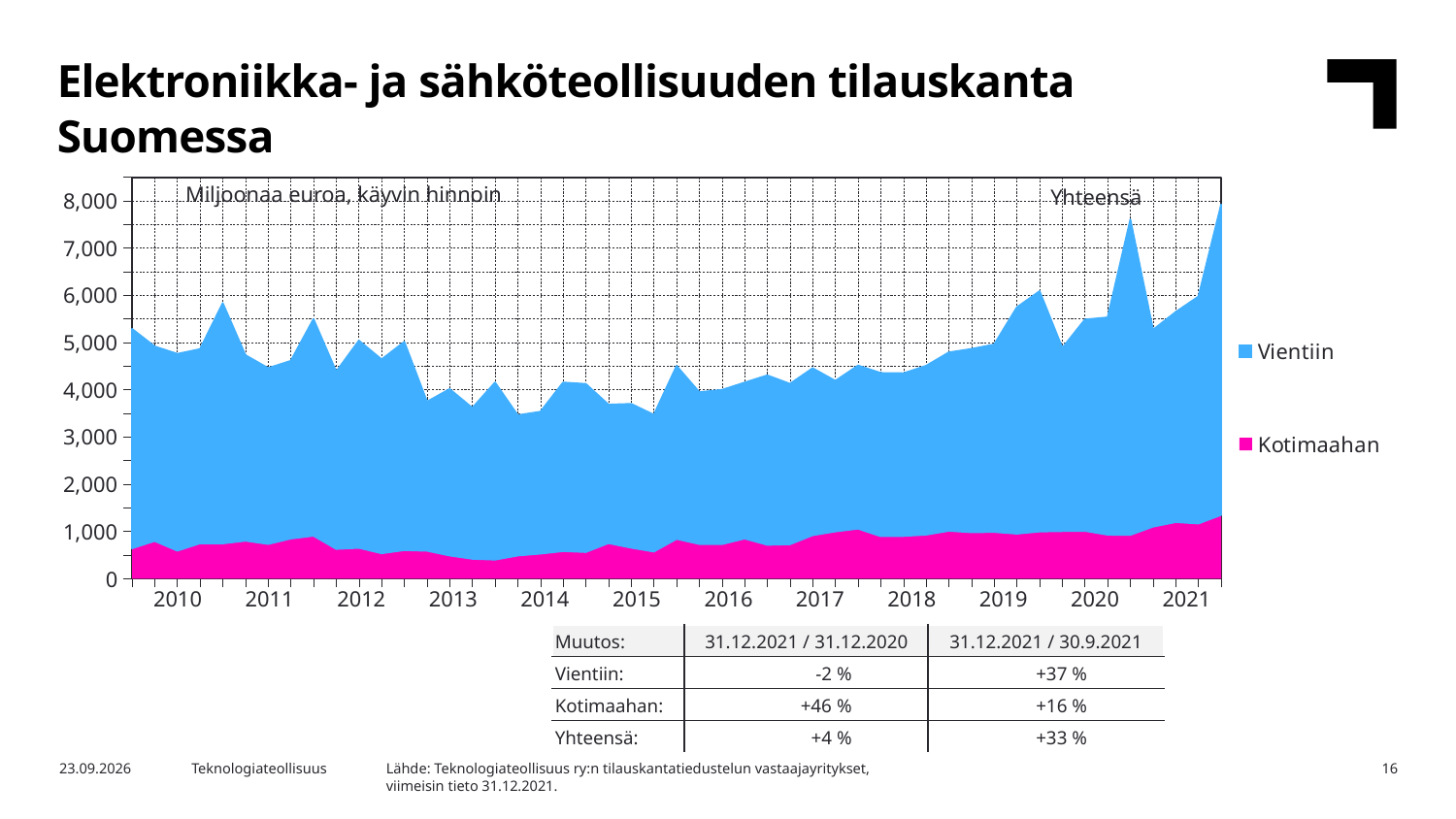
In which year does the total (Yhteensä) reach its highest point on the chart? 2021 Is the total (Yhteensä) value during 2015 greater or less than 5,000? less How many series does the chart legend list? 2 Is the Kotimaahan value at the end of 2021 greater or less than 1,000? greater What kind of chart is shown on the slide? Stacked area chart Does the Kotimaahan series generally rise or fall from 2018 to the end of 2021? rise What unit is stated in the chart's subtitle? Miljoonaa euroa, käyvin hinnoin Is the total (Yhteensä) value at the end of 2021 greater or less than 7,000? greater According to the table below the chart, what is the change in Vientiin for 31.12.2021 / 31.12.2020? -2 % How many years are labelled on the x axis of the chart? 12 Which two series are listed in the chart legend? Vientiin and Kotimaahan